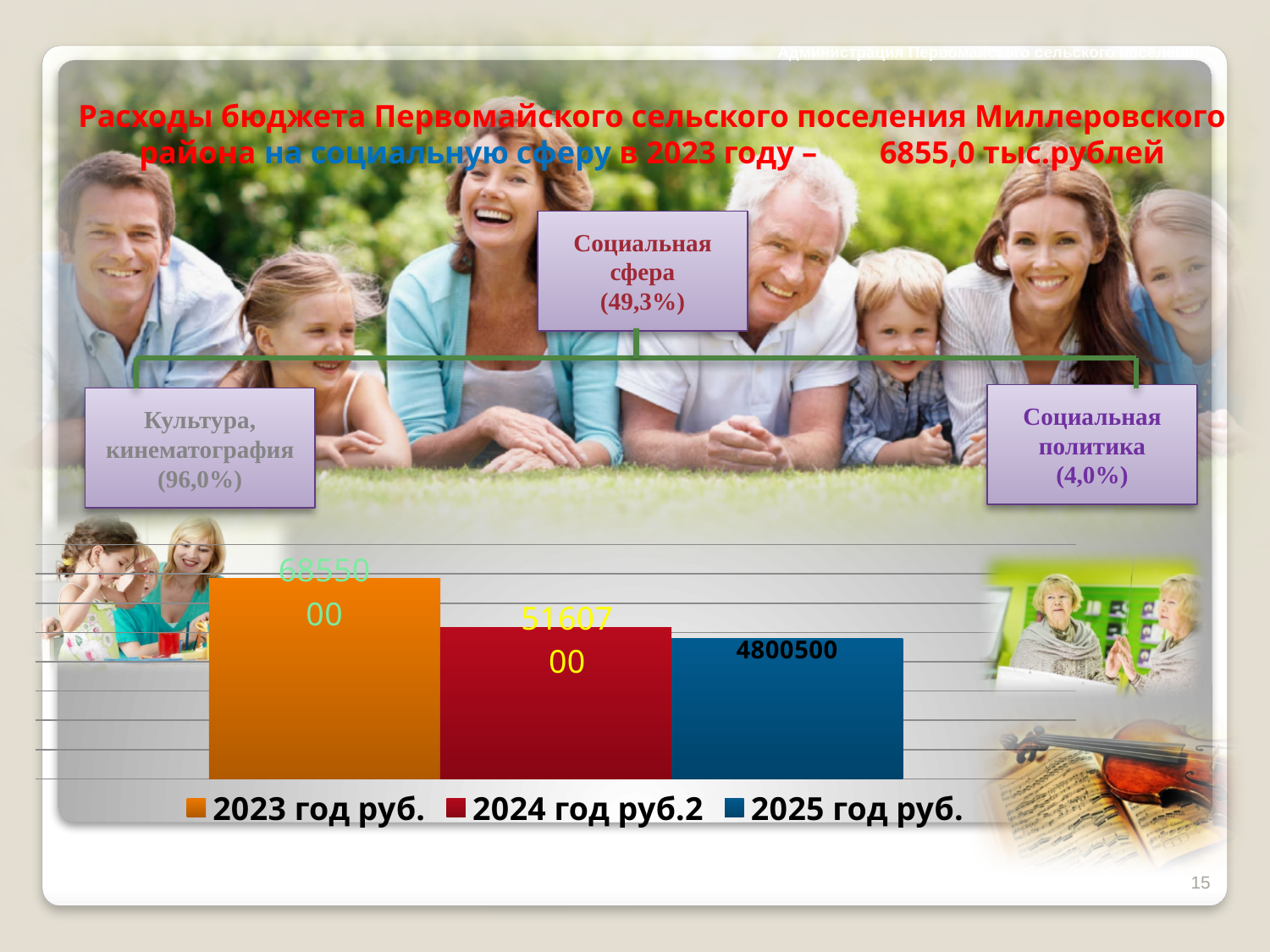
What value is shown for the 2023 год руб. bar in the bar chart? 6855000 What is the difference between the 2023 год руб. value and the 2024 год руб.2 value in the bar chart? 1694300 What is the difference between the 2024 год руб.2 value and the 2025 год руб. value in the bar chart? 360200 How many series does the legend of the bar chart list? 3 What value is shown for the 2024 год руб.2 bar in the bar chart? 5160700 Which series has the highest value in the bar chart? 2023 год руб. What value is shown for the 2025 год руб. bar in the bar chart? 4800500 Which series has the lowest value in the bar chart? 2025 год руб. Which is larger in the bar chart: the 2023 год руб. value or the 2025 год руб. value? 2023 год руб. What kind of chart is shown at the bottom of the slide? bar chart How many bars are plotted in the bar chart? 3 Do the values in the bar chart rise or fall from 2023 to 2025? fall